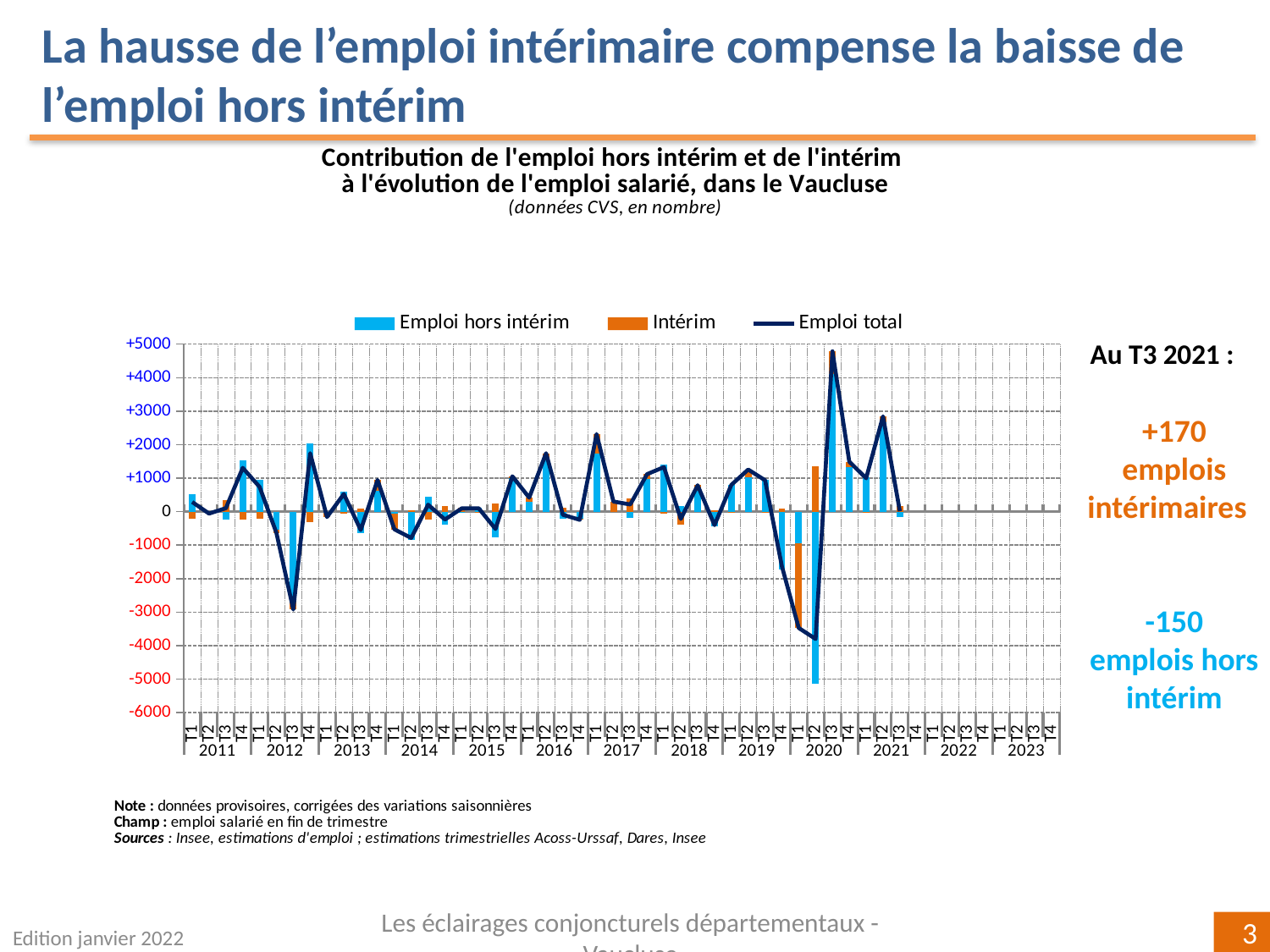
Is the Emploi hors intérim value for T2 2020 greater or less than -4000? less In which quarter does the Emploi hors intérim series reach its highest value? T3 2020 In which quarter does the Emploi total line reach its lowest point? T2 2020 Is the Emploi total value for T3 2012 greater or less than -2000? less Which is larger, the Intérim value for T2 2020 or the Intérim value for T3 2020? T2 2020 In which quarter does the Emploi hors intérim series reach its lowest value? T2 2020 How many series does the chart legend list? 3 What are the three series listed in the chart legend? Emploi hors intérim, Intérim, Emploi total What kind of chart is shown on the slide? A combined bar and line chart According to the annotation on the slide, what is the value for emplois hors intérim at T3 2021? -150 According to the annotation on the slide, what is the value for emplois intérimaires at T3 2021? +170